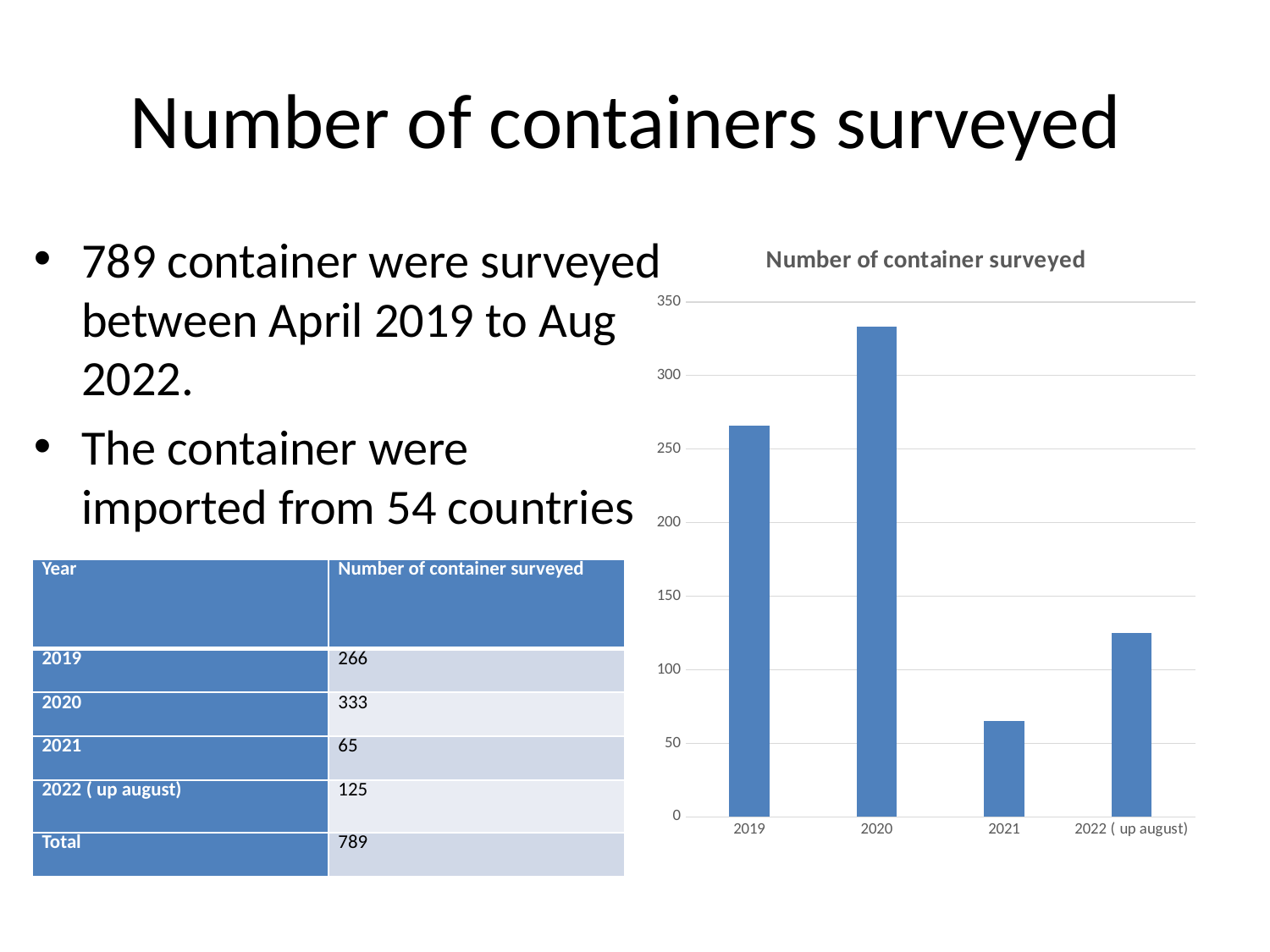
Is the value for 2021 greater or less than 100? less Which year has the lowest number of containers surveyed in the chart? 2021 Is the value for 2020 greater or less than 300? greater What type of chart is shown on the slide? bar chart According to the slide, how many containers were surveyed in 2020? 333 How many categories (years) are shown on the x axis of the chart? 4 What is the title of the chart? Number of container surveyed What is the difference between the number of containers surveyed in 2020 and in 2021? 268 Is the value for 2019 greater or less than 250? greater Which is larger, the value for 2019 or the value for 2022 ( up august)? 2019 Which year has the highest number of containers surveyed in the chart? 2020 According to the slide, how many containers were surveyed in 2022 ( up august)? 125